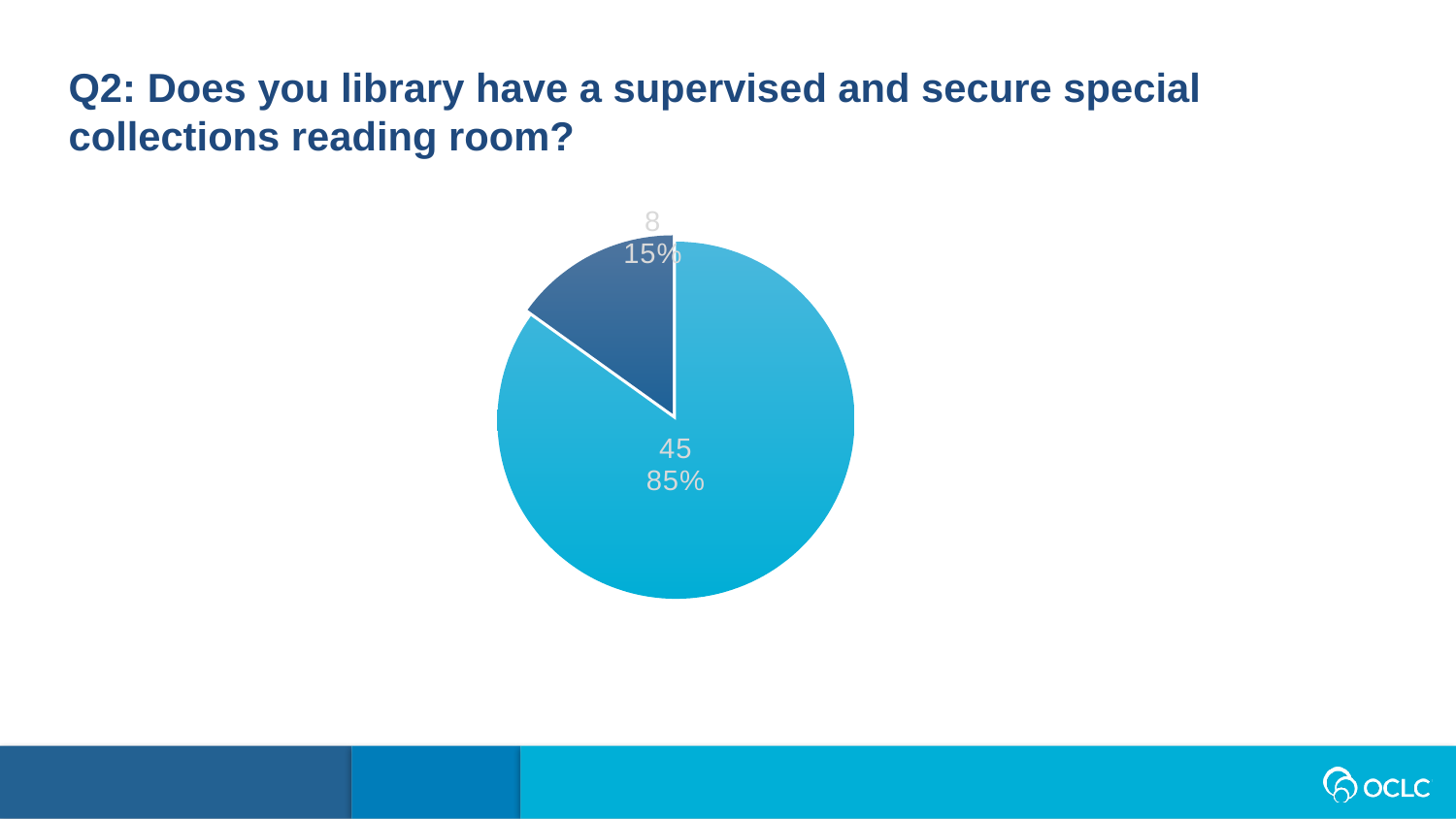
What percentage share does the larger, light blue slice represent? 85% What is the difference between the counts of the larger and smaller slices? 37 What count is printed on the larger, light blue slice of the pie chart? 45 What question does the slide title say the chart answers? Q2: Does you library have a supervised and secure special collections reading room? What count is printed on the smaller, dark blue slice of the pie chart? 8 What is the total of the two counts shown on the pie chart? 53 What percentage share does the smaller, dark blue slice represent? 15% What kind of chart is shown on the slide? pie chart Which slice is larger, the light blue one or the dark blue one? the light blue one How many slices does the pie chart have? 2 Which slice has the smallest value in the pie chart? the dark blue slice (8, 15%)